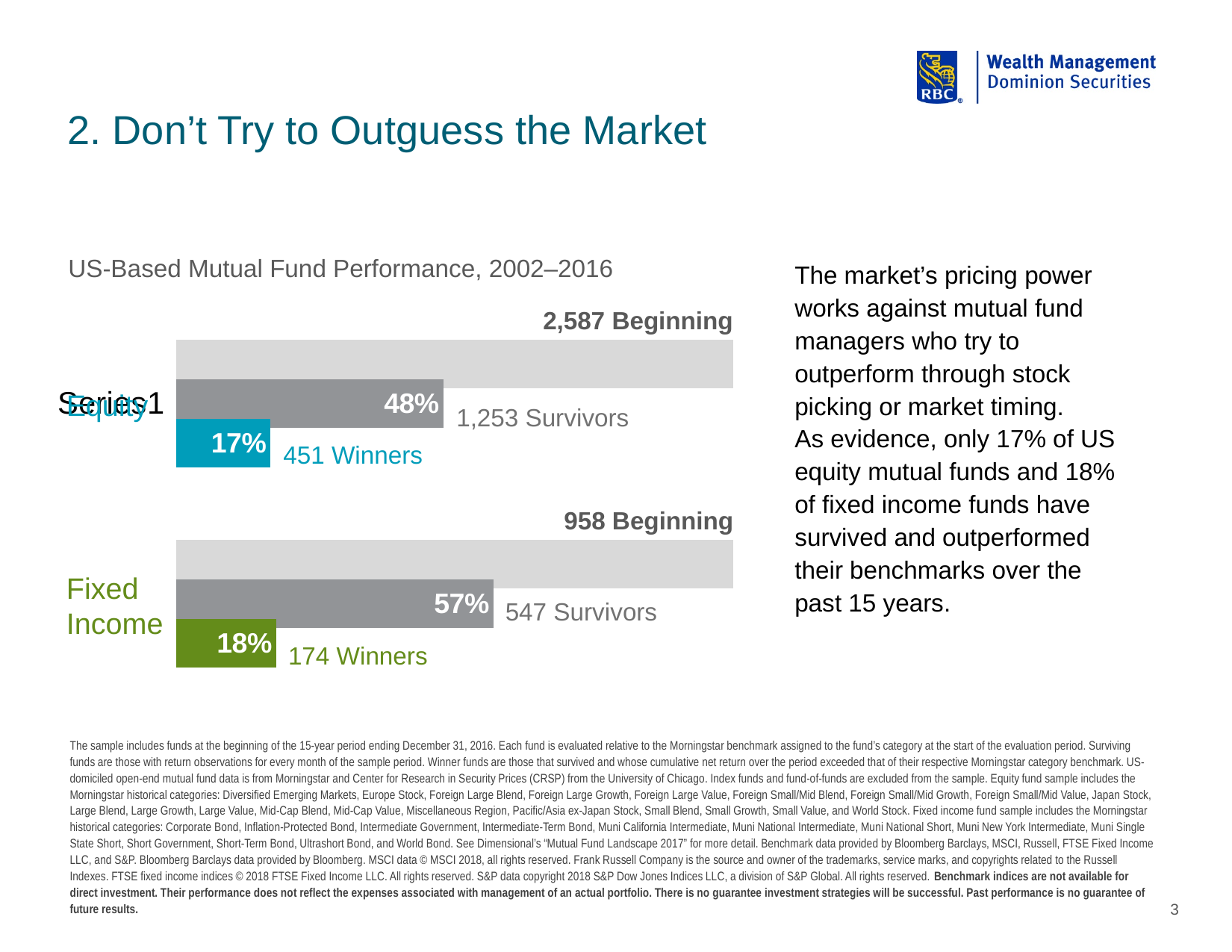
How many Fixed Income funds were Winners? 174 How many fund categories are shown in the chart? 2 How many Equity funds were Survivors? 1,253 How many Fixed Income funds were there at the beginning of the period? 958 Which category had more funds at the beginning of the period, Equity or Fixed Income? Equity What percentage of Fixed Income funds were Survivors? 57% How many funds were there at the beginning of the period for Equity? 2,587 What is the difference between the number of Fixed Income funds at the beginning and the number of Fixed Income Survivors? 411 What is the title of the chart on the slide? US-Based Mutual Fund Performance, 2002–2016 What percentage of Equity funds were Winners? 17% What kind of chart is shown on the slide? bar chart What is the difference between the number of Equity Survivors and Equity Winners? 802